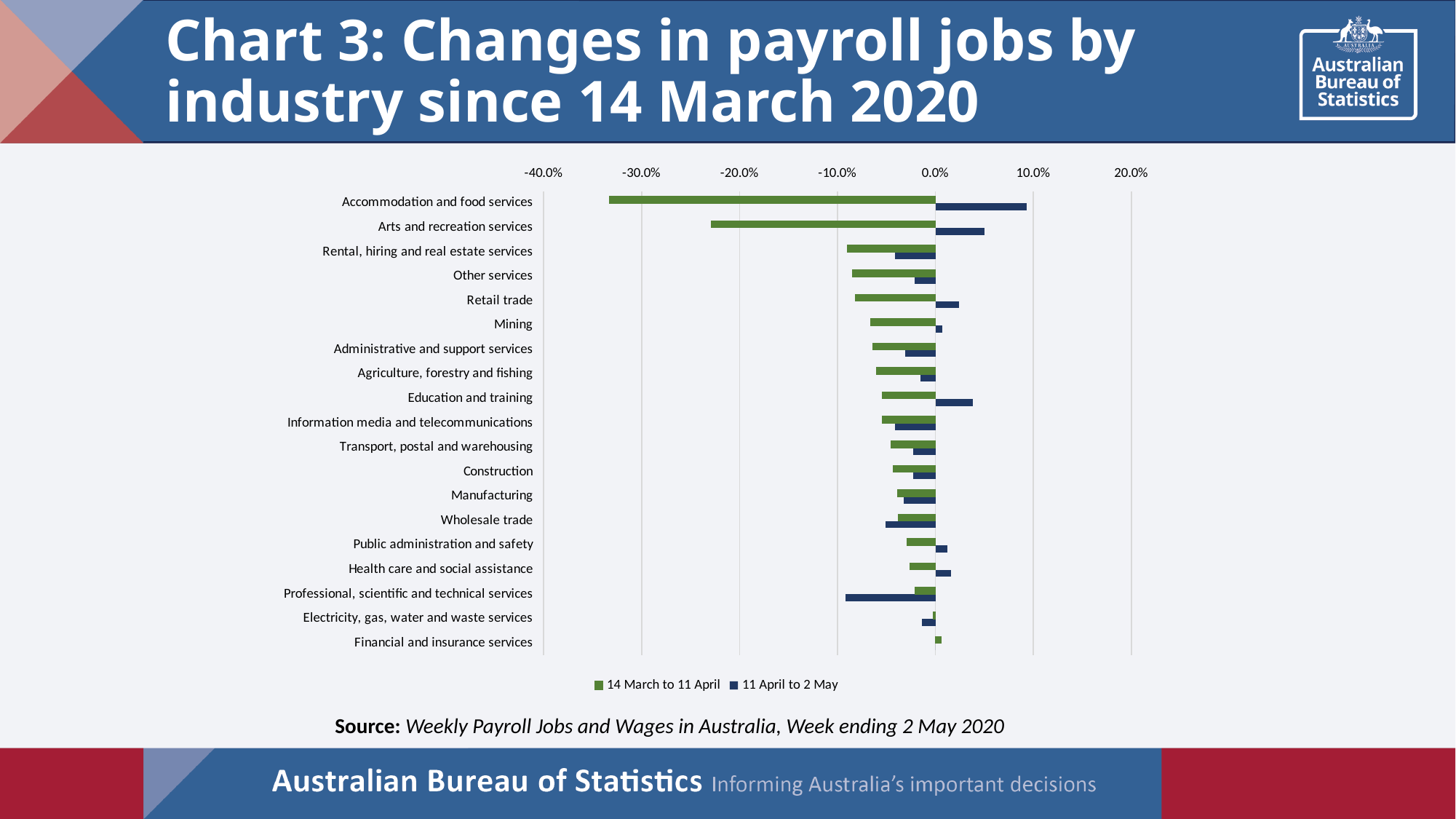
How many industries are plotted on the chart? 19 Which industry has the lowest value for the 11 April to 2 May series? Professional, scientific and technical services Is the 14 March to 11 April value for Accommodation and food services greater or less than -30.0%? less Which industry has the lowest value for the 14 March to 11 April series? Accommodation and food services Is the 14 March to 11 April value for Arts and recreation services greater or less than -20.0%? less How many series does the legend list? 2 What kind of chart is shown on the slide? Bar chart What are the two series named in the legend? 14 March to 11 April; 11 April to 2 May Is the 11 April to 2 May value for Arts and recreation services greater or less than 0.0%? greater Which industry has the highest value for the 11 April to 2 May series? Accommodation and food services For the 11 April to 2 May series, which is larger: Accommodation and food services or Arts and recreation services? Accommodation and food services